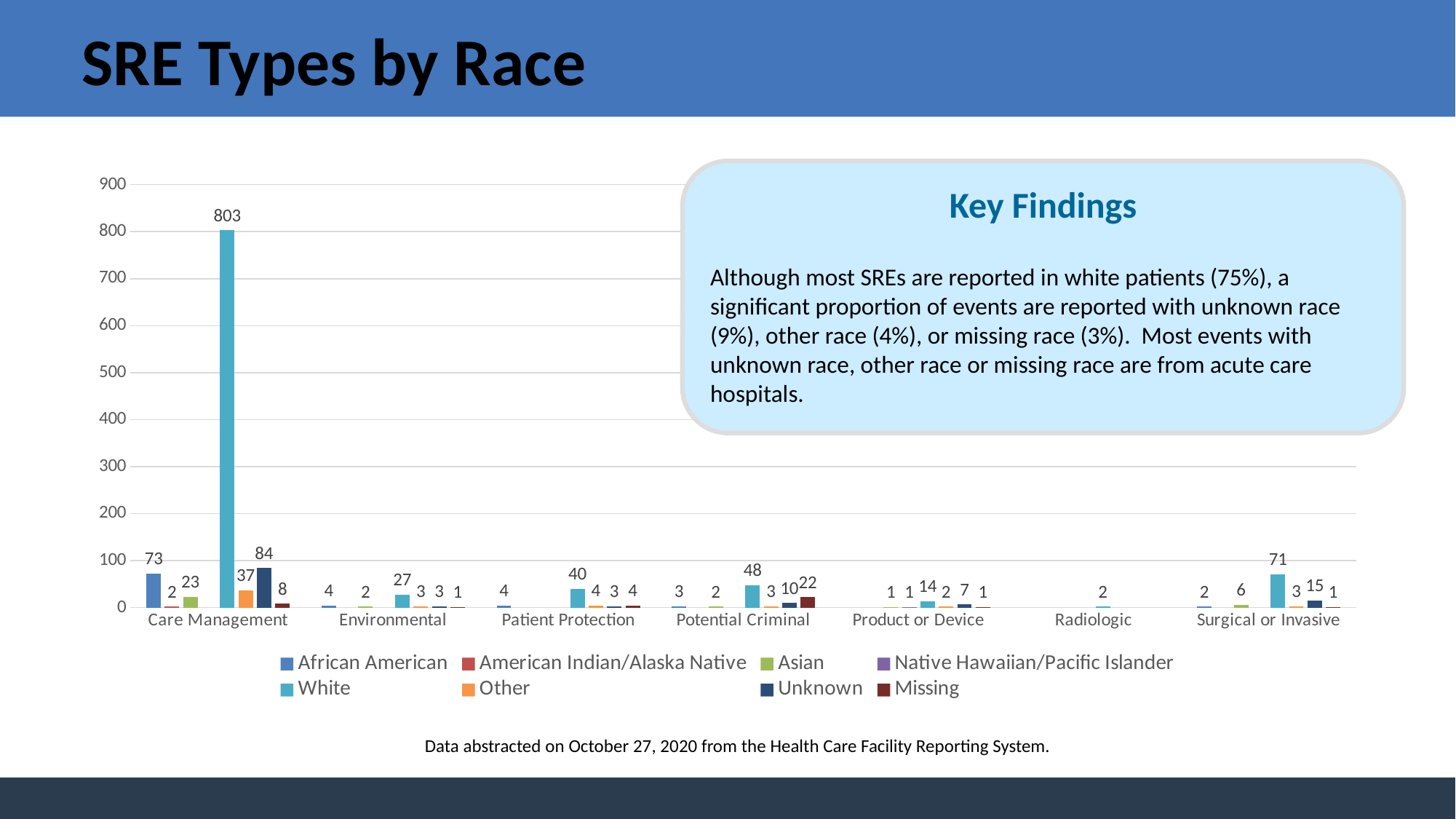
How many SRE type categories are shown on the x axis? 7 How many series does the legend list? 8 What kind of chart is shown on the slide? bar chart What is the title of the slide? SRE Types by Race What is the value for Unknown in the Care Management category? 84 Is the value for White in Care Management greater or less than 500? greater What is the value for Missing in the Potential Criminal category? 22 What is the value for White in the Care Management category? 803 Which category has the highest value for the White series? Care Management What is the difference between the White and Unknown values in the Care Management category? 719 Which is larger: the White value for Potential Criminal or the White value for Patient Protection? Potential Criminal What is the value for White in the Surgical or Invasive category? 71